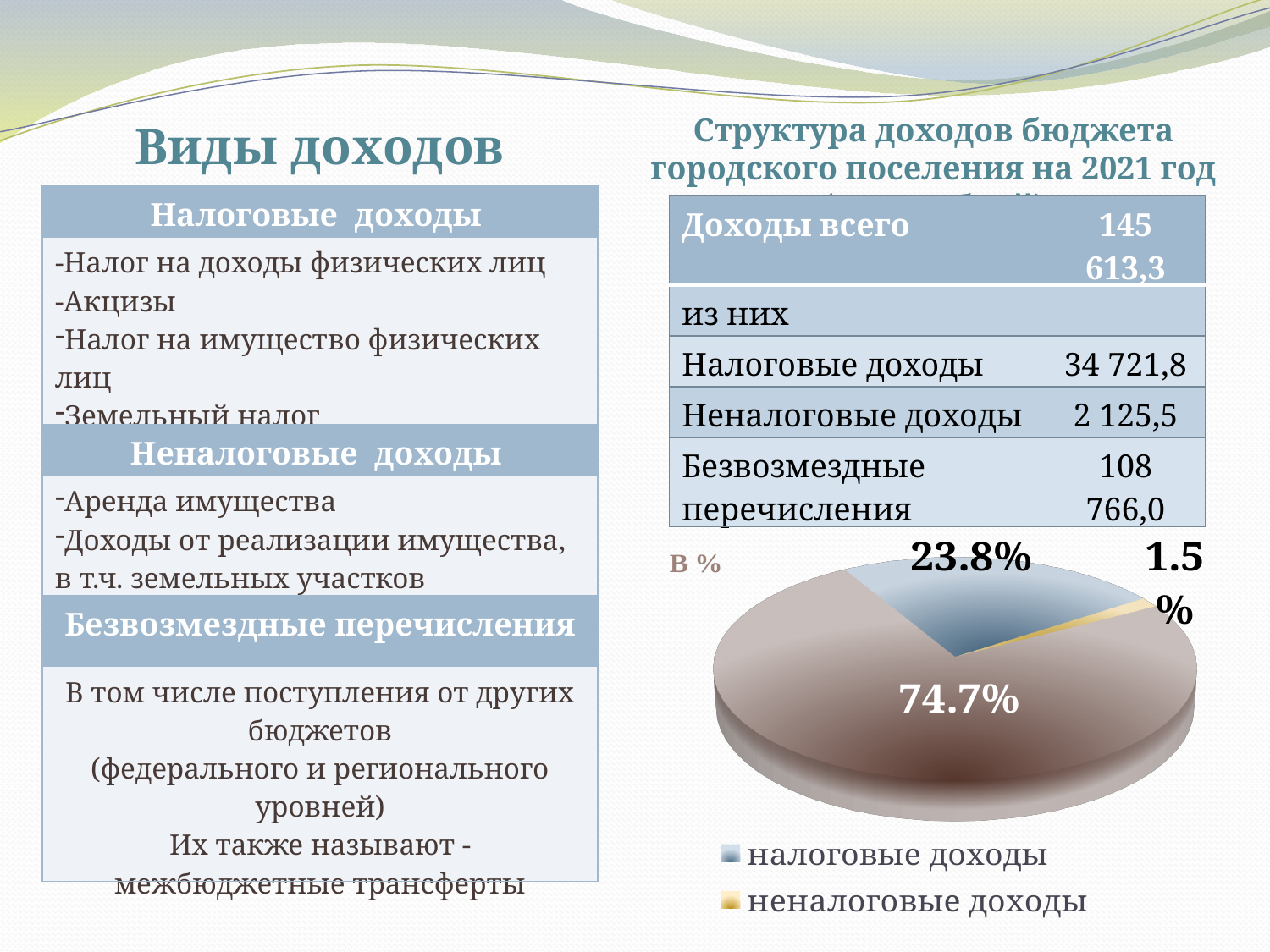
How many slices does the pie chart have? 3 What percentage is labelled on the largest slice of the pie chart? 74.7% What kind of chart is shown on the right side of the slide? pie chart Which two legend entries are readable below the pie chart? налоговые доходы, неналоговые доходы What unit label is printed to the left of the pie chart? В % Which legend category has the smallest slice in the pie chart? неналоговые доходы Is the largest slice of the pie chart greater or less than 50%? greater In the pie chart, what share is shown for неналоговые доходы? 1.5% Is the share for налоговые доходы greater or less than 25%? less Which slice is larger in the pie chart: налоговые доходы or неналоговые доходы? налоговые доходы In the pie chart, what share is shown for налоговые доходы? 23.8% By how many percentage points does the налоговые доходы slice exceed the неналоговые доходы slice? 22.3